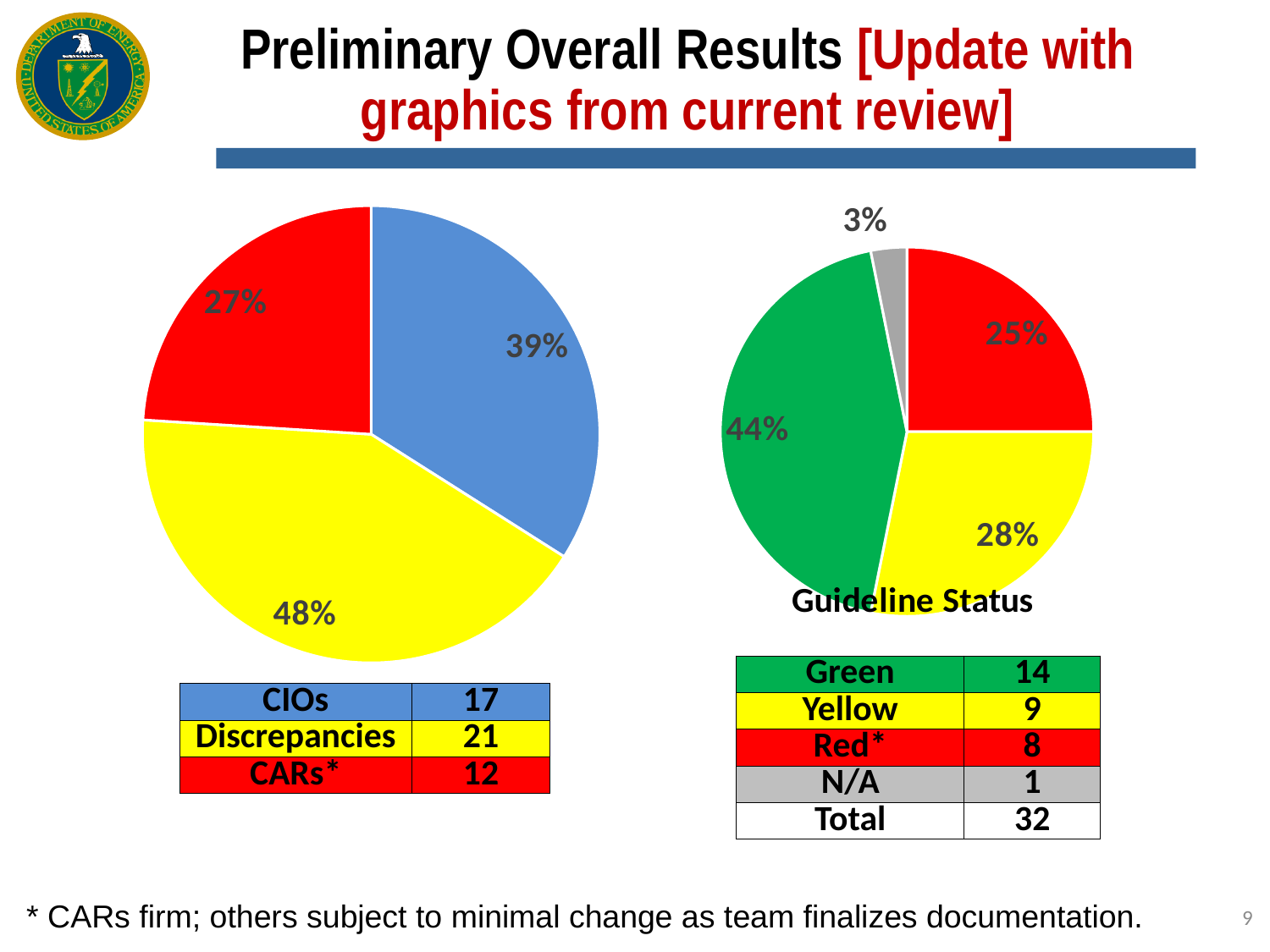
In the Guideline Status pie chart, which slice is the smallest? The grey slice (3%) How many slices does the left pie chart have? 3 What kind of chart is the chart on the left side of the slide? Pie chart In the Guideline Status pie chart, what is the difference in percentage points between the green slice and the red slice? 19 percentage points What is the title of the pie chart on the right side of the slide? Guideline Status In the left pie chart, which slice is the largest? The yellow slice (48%) In the left pie chart, what percentage is shown on the blue slice? 39% In the left pie chart, what percentage is shown on the red slice? 27% In the left pie chart, which is larger, the blue slice or the red slice? The blue slice In the left pie chart, what percentage is shown on the yellow slice? 48% In the Guideline Status pie chart, what percentage is shown on the green slice? 44% How many slices does the Guideline Status pie chart have? 4